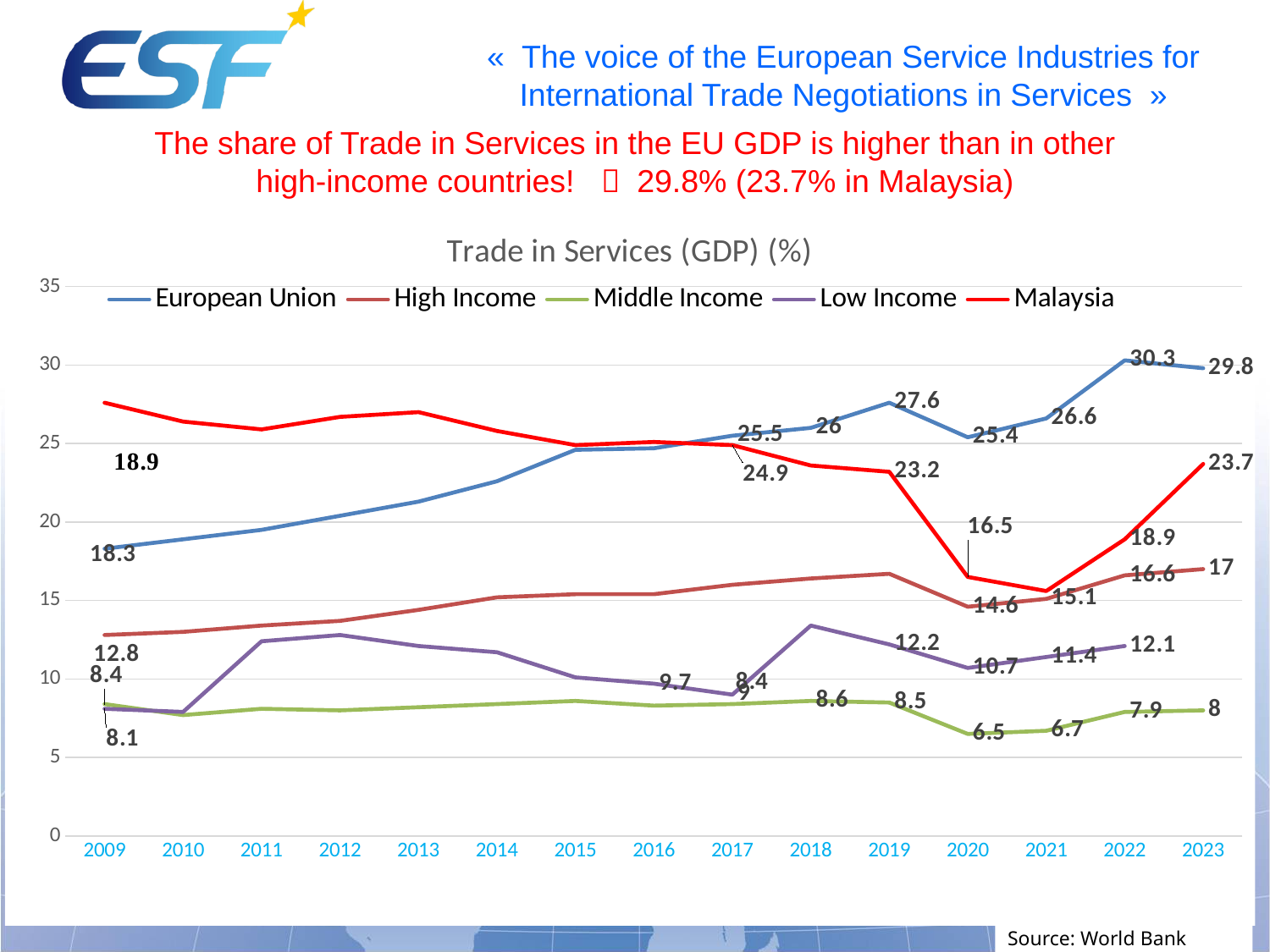
How many series does the legend list? 5 What type of chart is shown on the slide? line chart What is the value for High Income in 2023? 17 What is the difference between the European Union and Malaysia values in 2023? 6.1 Is the value for Malaysia in 2009 greater or less than 25? greater How many years are shown on the x axis? 15 Does the European Union line rise or fall from 2009 to 2019? rise What is the value for Malaysia in 2020? 16.5 Which is larger in 2019, the European Union value or the Malaysia value? European Union What is the value for Middle Income in 2020? 6.5 In which year does the European Union line reach its highest value? 2022 What is the value for the European Union in 2023? 29.8